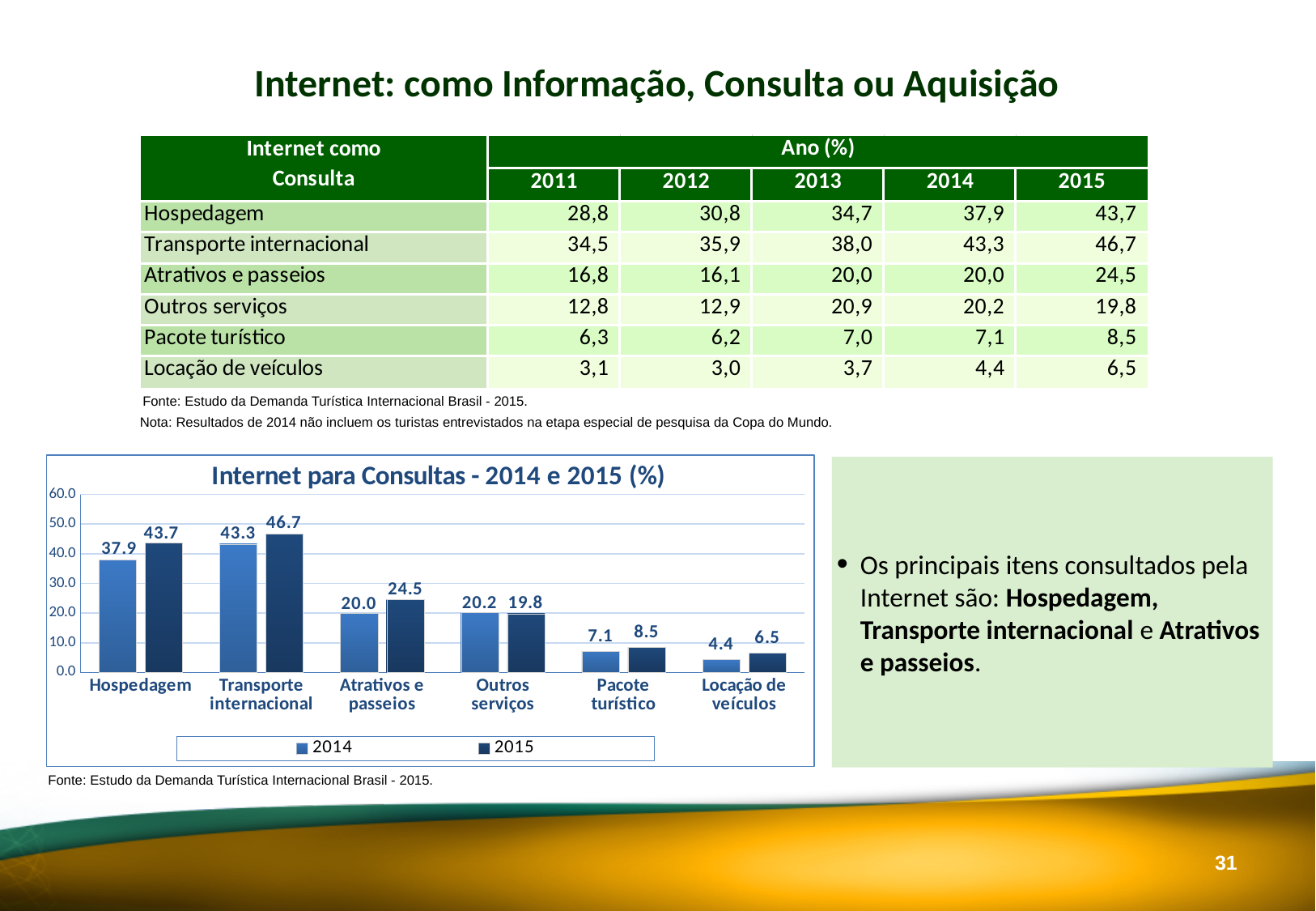
How many categories are shown on the x axis of the chart? 6 Which category has the lowest 2014 value in the chart? Locação de veículos Which is larger for Outros serviços in the chart: the 2014 value or the 2015 value? 2014 What kind of chart is shown on the slide? Bar chart What is the title of the chart? Internet para Consultas - 2014 e 2015 (%) What is the 2015 value for Pacote turístico in the chart? 8.5 How many series does the chart legend list? 2 What is the 2014 value for Hospedagem in the chart? 37.9 What is the difference between the 2015 and 2014 values for Hospedagem in the chart? 5.8 Which category has the highest 2015 value in the chart? Transporte internacional What is the 2015 value for Transporte internacional in the chart? 46.7 Is the 2015 value for Atrativos e passeios greater or less than 20.0? greater